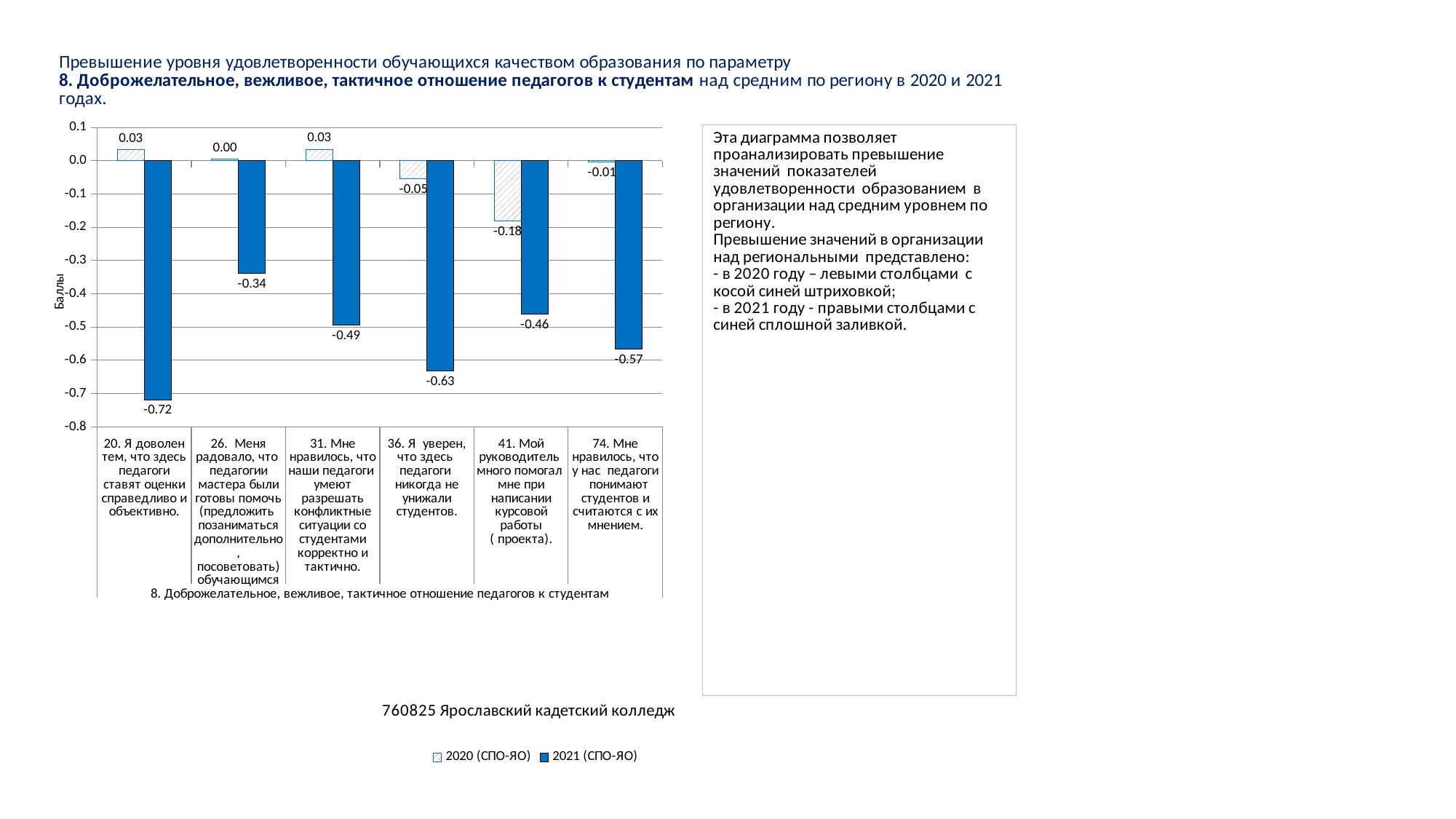
Which is larger: the 2021 value for category 41 or the 2021 value for category 74? Category 41 (-0.46) What is the 2021 (СПО-ЯО) value for category "36. Я уверен, что здесь педагоги никогда не унижали студентов."? -0.63 Which category has the lowest 2021 (СПО-ЯО) value? 20. Я доволен тем, что здесь педагоги ставят оценки справедливо и объективно. What is the 2021 (СПО-ЯО) value for category "20. Я доволен тем, что здесь педагоги ставят оценки справедливо и объективно."? -0.72 What is the difference between the 2020 and 2021 values for category "31. Мне нравилось, что наши педагоги умеют разрешать конфликтные ситуации со студентами корректно и тактично."? 0.52 What is the 2020 (СПО-ЯО) value for category "41. Мой руководитель много помогал мне при написании курсовой работы ( проекта)."? -0.18 How many categories are shown on the x axis? 6 Which category has the highest 2021 (СПО-ЯО) value? 26. Меня радовало, что педагоги мастера были готовы помочь (предложить позаниматься дополнительно, посоветовать) обучающимся How many series does the legend list? 2 What is the label of the y axis? Баллы What are the two series named in the legend? 2020 (СПО-ЯО) and 2021 (СПО-ЯО) What type of chart is shown? Bar chart